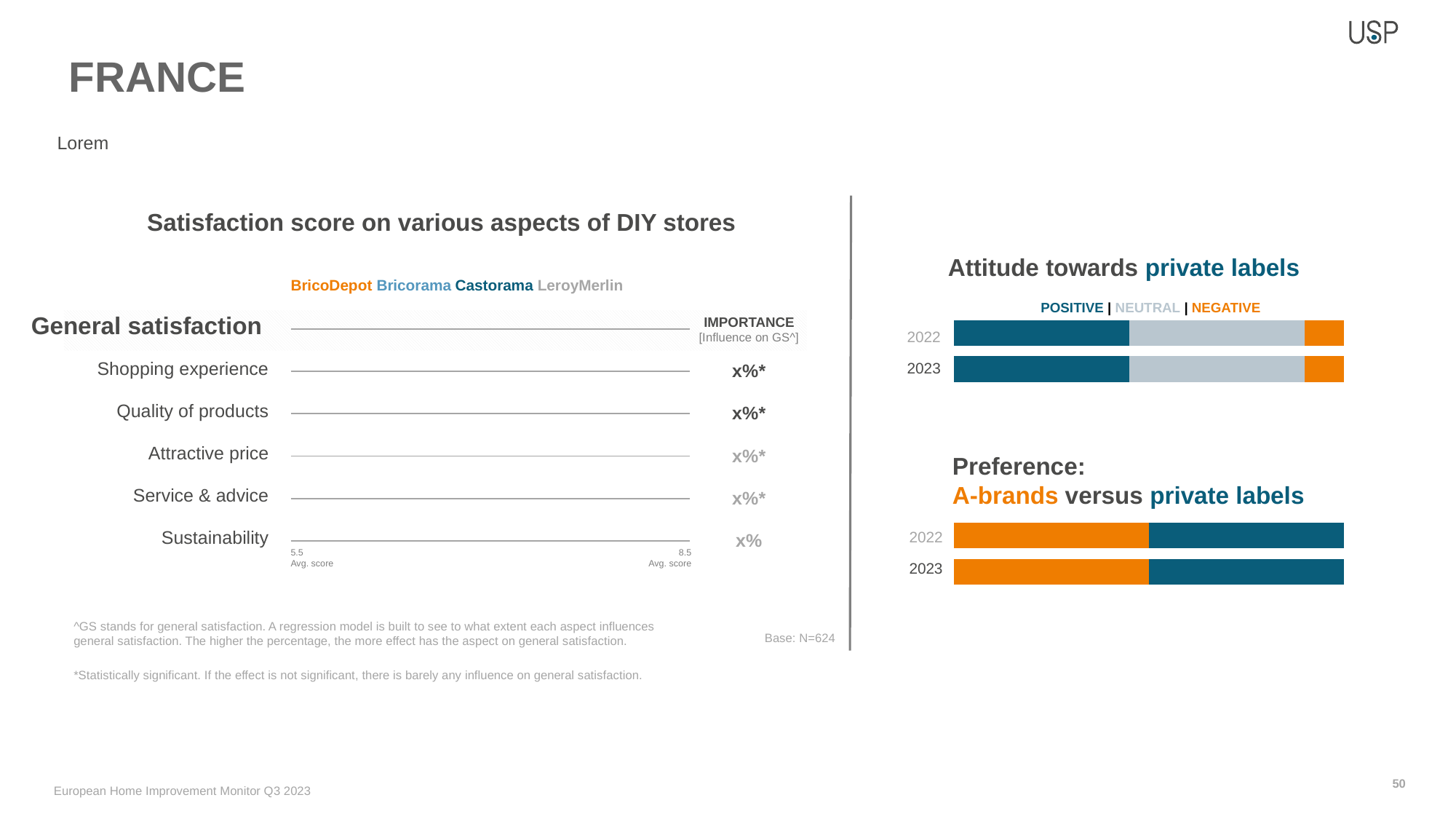
What is the range of the average score axis in the 'Satisfaction score on various aspects of DIY stores' chart? 5.5 to 8.5 What are the legend entries of the 'Attitude towards private labels' chart? Positive, Neutral, Negative What kind of chart is the 'Preference: A-brands versus private labels' chart? stacked bar chart How many aspects (excluding General satisfaction) are listed in the 'Satisfaction score on various aspects of DIY stores' chart? 5 In the 'Attitude towards private labels' chart for 2022, which segment is larger: Positive or Negative? Positive What kind of chart is the 'Attitude towards private labels' chart? stacked bar chart In the 'Attitude towards private labels' chart, which attitude has the smallest segment in 2023? Negative How many store brands are listed in the legend of the 'Satisfaction score on various aspects of DIY stores' chart? 4 Which colour represents A-brands in the 'Preference: A-brands versus private labels' chart? orange How many years are shown in the 'Preference: A-brands versus private labels' chart? 2 How many years are shown in the 'Attitude towards private labels' chart? 2 How many series does the legend of the 'Attitude towards private labels' chart list? 3